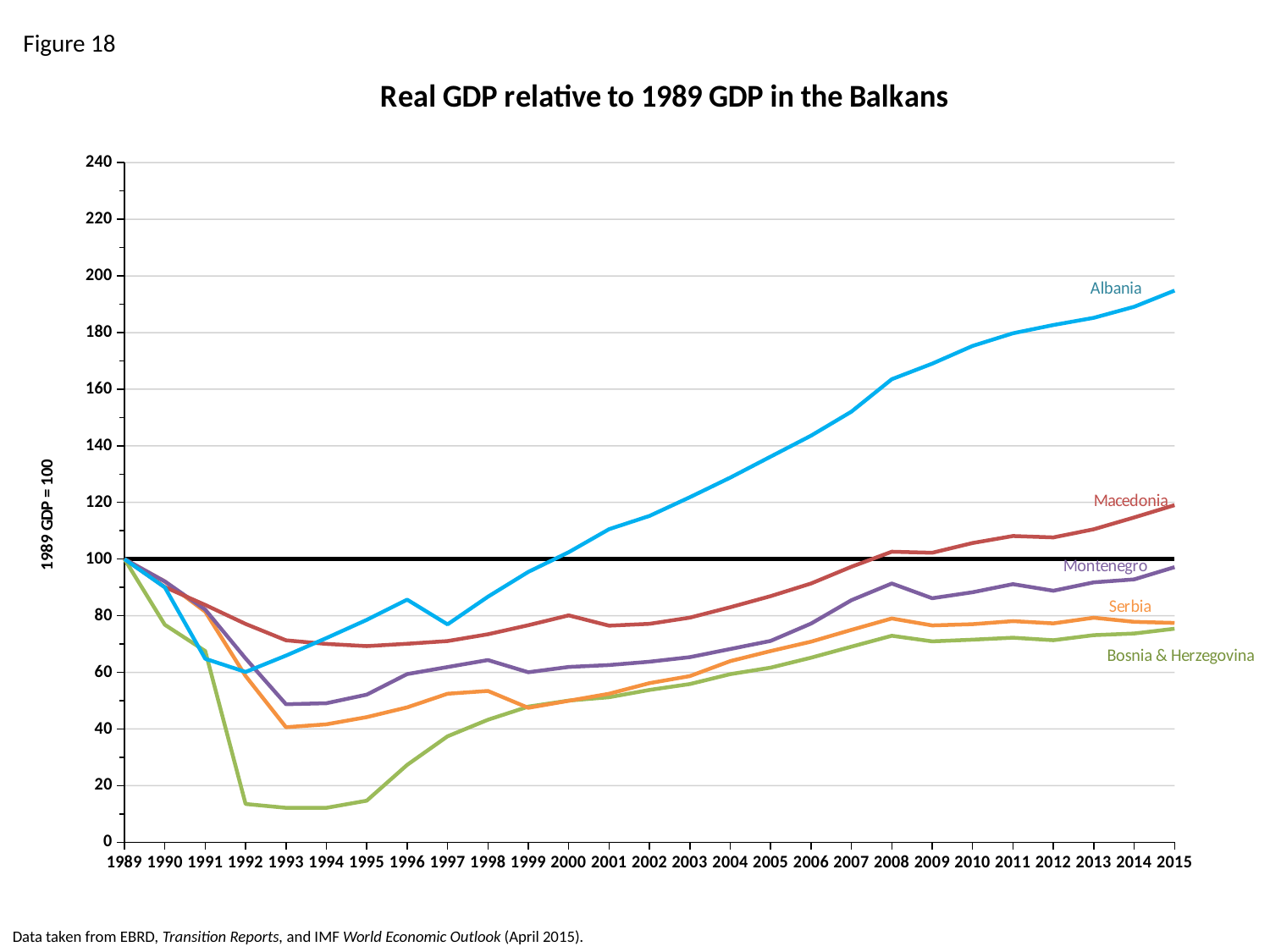
In 1994, which is larger, the value for Montenegro or the value for Serbia? Montenegro How many countries are plotted in the chart? 5 What is the title of the chart? Real GDP relative to 1989 GDP in the Balkans Is the value for Albania in 2015 greater or less than 180? greater Does the value for Albania rise or fall from 2000 to 2015? rise What kind of chart is shown on the slide? line chart Is the value for Macedonia in 2015 greater or less than 100? greater How many years are shown along the x axis of the chart? 27 Which country has the highest value in 2015? Albania What is the value for Albania in 1989? 100 Is the value for Bosnia & Herzegovina in 1993 greater or less than 20? less Which country has the lowest value in 1993? Bosnia & Herzegovina